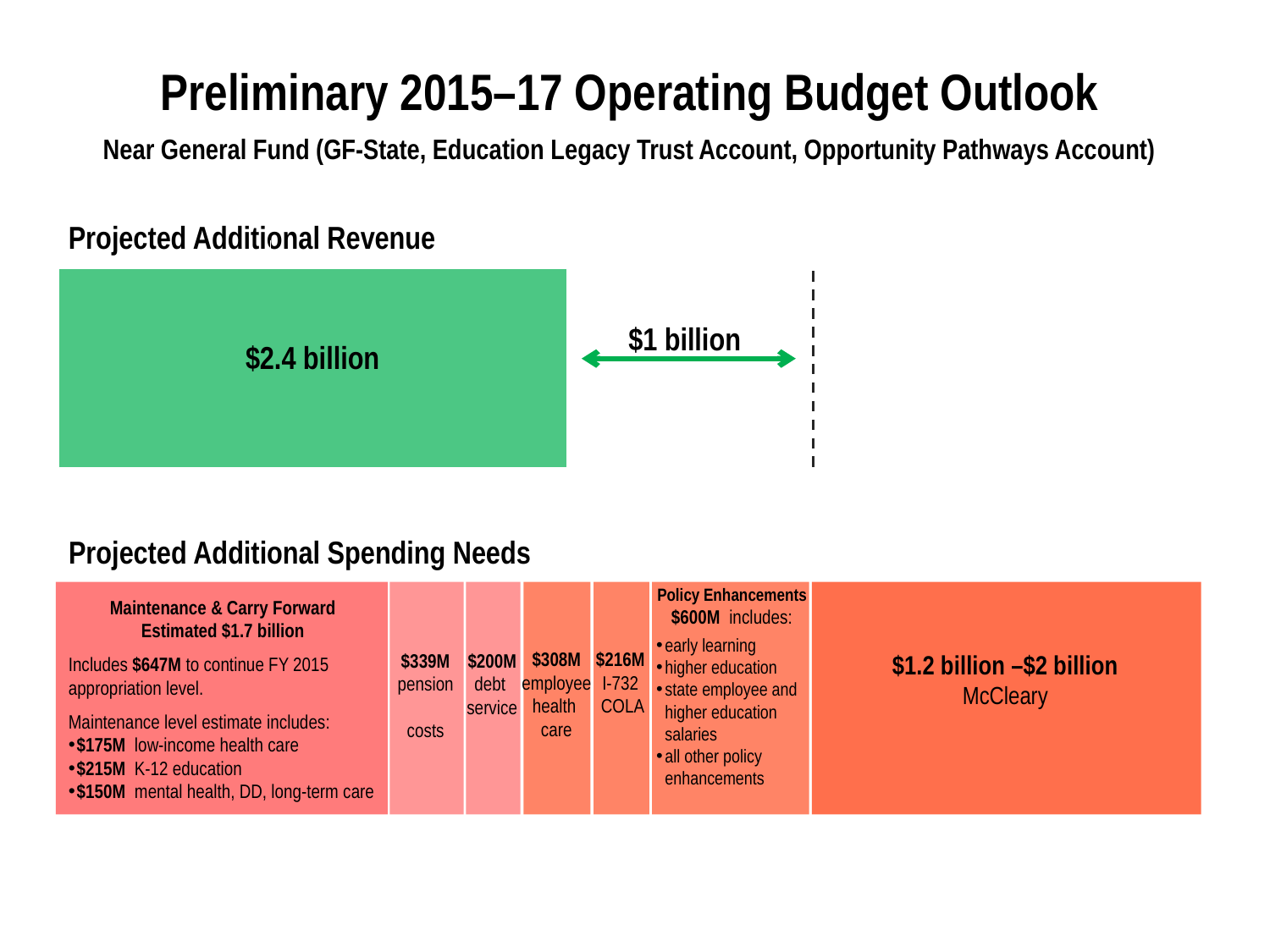
In the Projected Additional Spending Needs bar, what is the amount for debt service? $200M In the Projected Additional Spending Needs bar, what is the amount for Policy Enhancements? $600M What is the difference between the employee health care amount and the I-732 COLA amount in the spending needs bar? $92M In the Projected Additional Spending Needs bar, what is the amount for pension costs? $339M What colour is the Projected Additional Revenue bar? green What is the projected additional revenue shown in the green bar? $2.4 billion In the Projected Additional Spending Needs bar, what is the amount for employee health care? $308M What amount is labelled on the arrow between the green revenue bar and the dashed line? $1 billion Which is larger in the Projected Additional Spending Needs bar: pension costs or debt service? pension costs In the Projected Additional Spending Needs bar, what is the amount for I-732 COLA? $216M In the Projected Additional Spending Needs bar, what range is given for McCleary? $1.2 billion –$2 billion In the Projected Additional Spending Needs bar, what is the estimated amount for Maintenance & Carry Forward? $1.7 billion